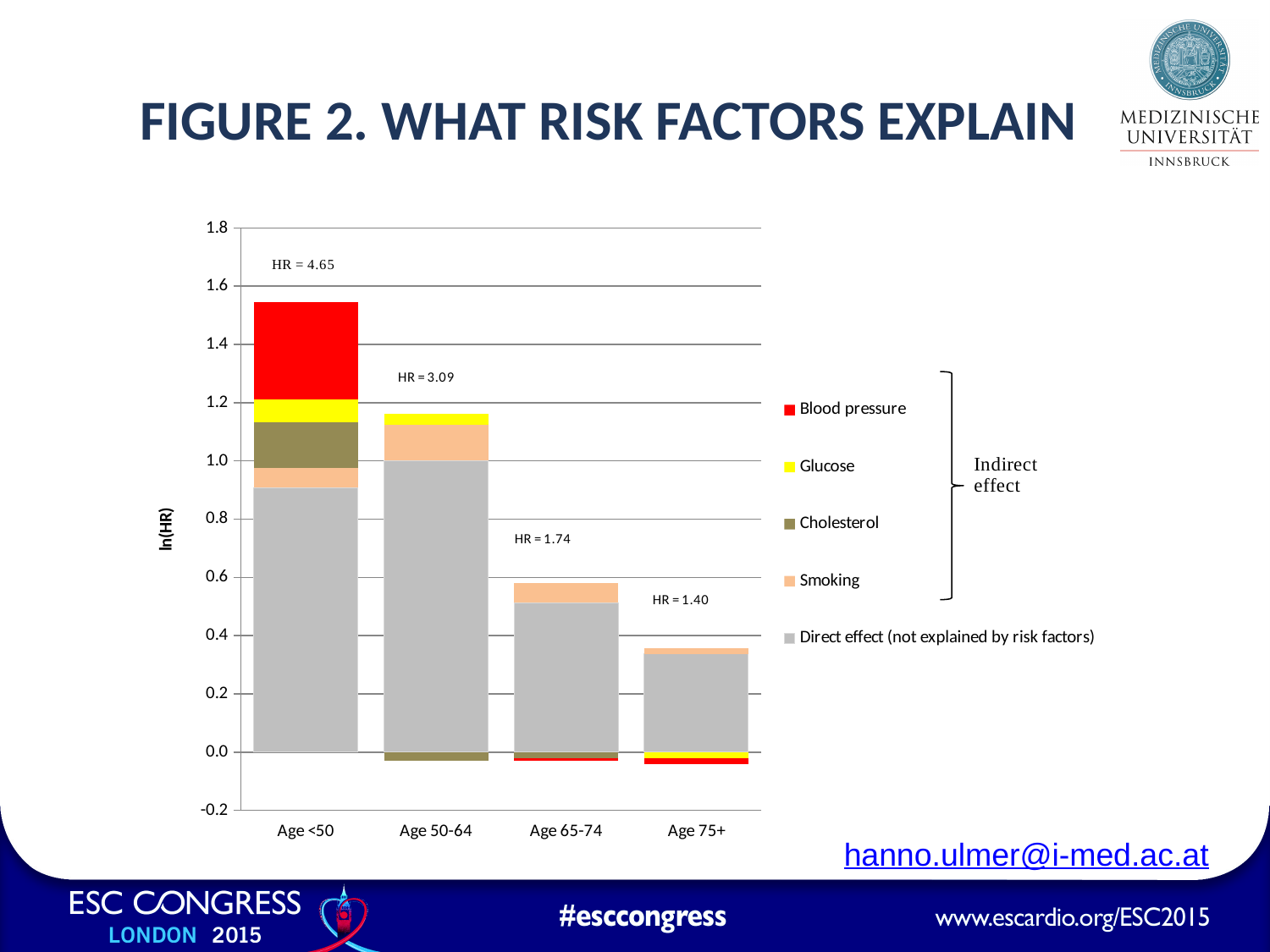
What is the HR value annotated for the Age <50 group? HR = 4.65 Is the direct effect (grey) value for Age 75+ greater or less than 0.4? less What is the label on the y axis? ln(HR) How many age groups are shown on the x axis? 4 Do the annotated HR values rise or fall as age increases along the x axis? Fall What kind of chart is shown on the slide? Stacked bar chart Which age group has the lowest annotated HR? Age 75+ What is the HR value annotated for the Age 75+ group? HR = 1.40 How many series does the legend list? 5 Which age group has the highest annotated HR? Age <50 What is the difference between the annotated HR for Age <50 and Age 50-64? 1.56 Which has the larger annotated HR, Age 50-64 or Age 65-74? Age 50-64